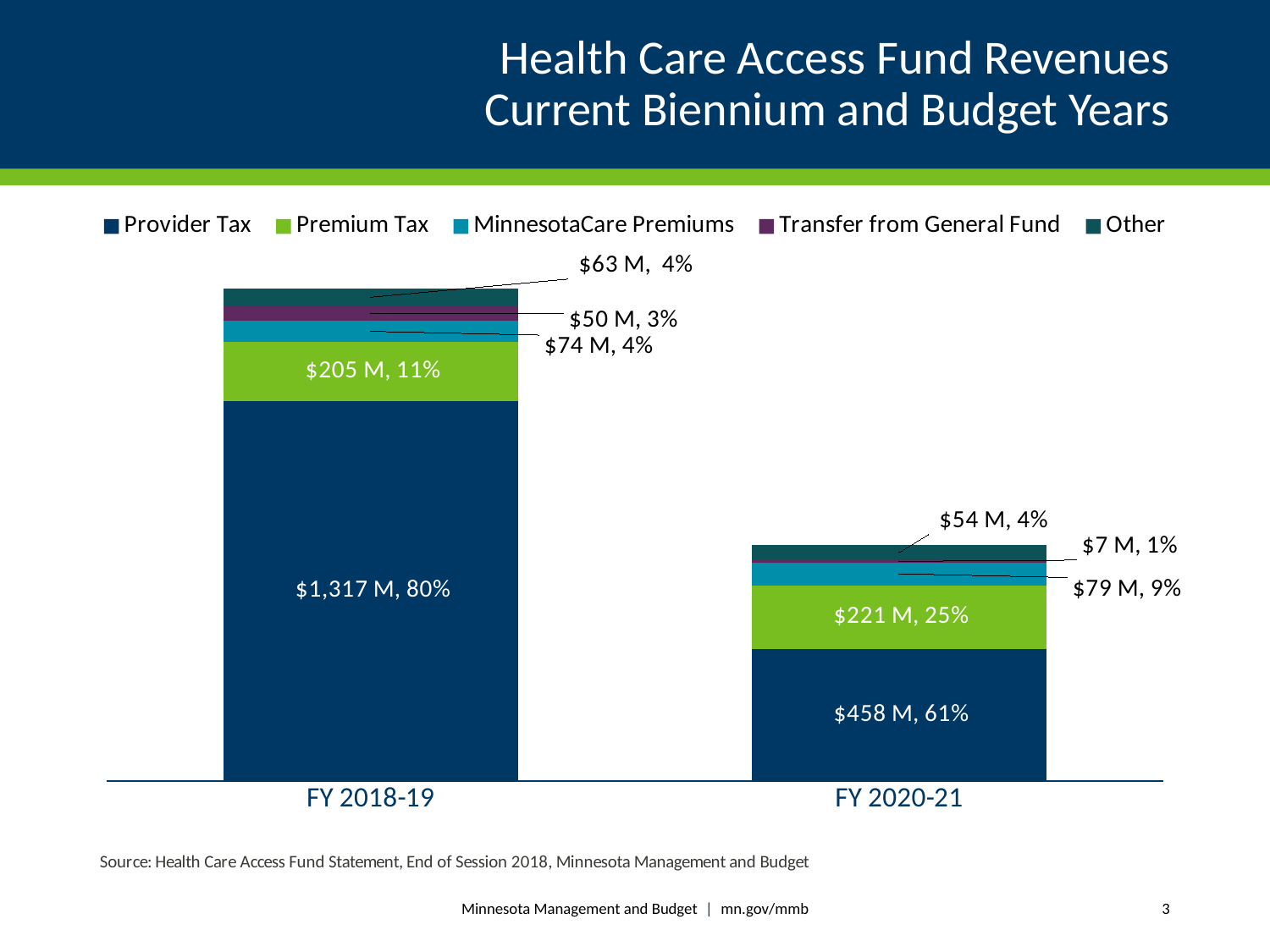
What percentage of FY 2020-21 revenues does Provider Tax represent? 61% What is the Provider Tax revenue for FY 2018-19? $1,317 M What percentage of FY 2018-19 revenues does Premium Tax represent? 11% What kind of chart is shown on the slide? Stacked bar chart How many series does the legend list? 5 What is the total of all labeled segments in the FY 2020-21 bar? $819 M Which biennium has the larger Premium Tax revenue, FY 2018-19 or FY 2020-21? FY 2020-21 Does Provider Tax revenue rise or fall from FY 2018-19 to FY 2020-21? Fall Which revenue source is the largest segment of the FY 2018-19 bar? Provider Tax By how much does Provider Tax revenue in FY 2018-19 exceed Provider Tax revenue in FY 2020-21? $859 M How many bienniums (categories) are plotted on the x axis? 2 What is the Premium Tax revenue for FY 2020-21? $221 M